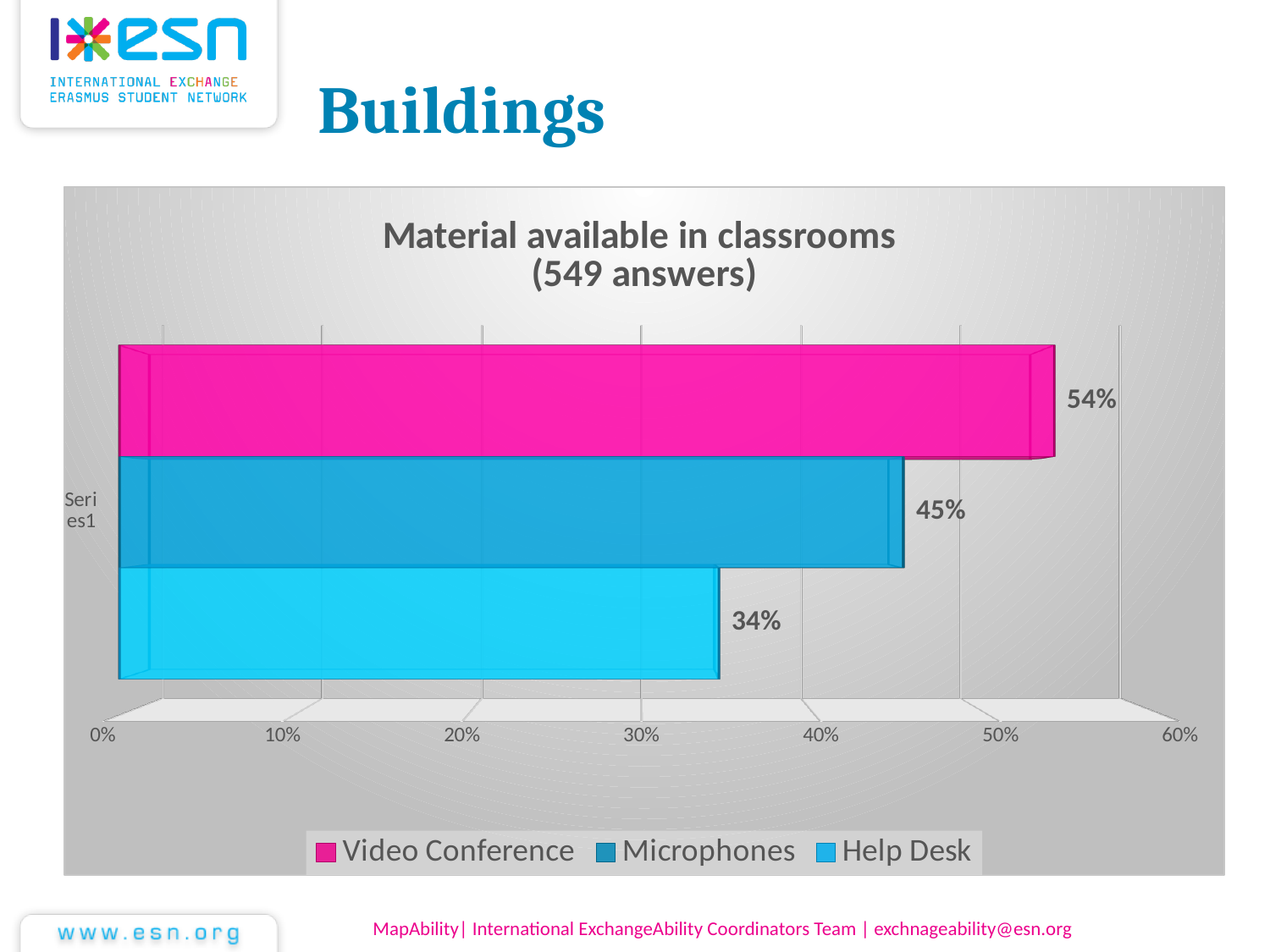
Which series has the highest value? Video Conference What is the value for Video Conference? 54% Is the value for Video Conference greater or less than 50%? greater Which series has the lowest value? Help Desk Which is larger, the value for Microphones or the value for Help Desk? Microphones How many series does the legend list? 3 What is the difference between the Microphones and Help Desk values? 11% What is the title of the chart? Material available in classrooms (549 answers) What is the difference between the Video Conference and Help Desk values? 20% What is the value for Help Desk? 34% What is the value for Microphones? 45% What kind of chart is shown on the slide? bar chart